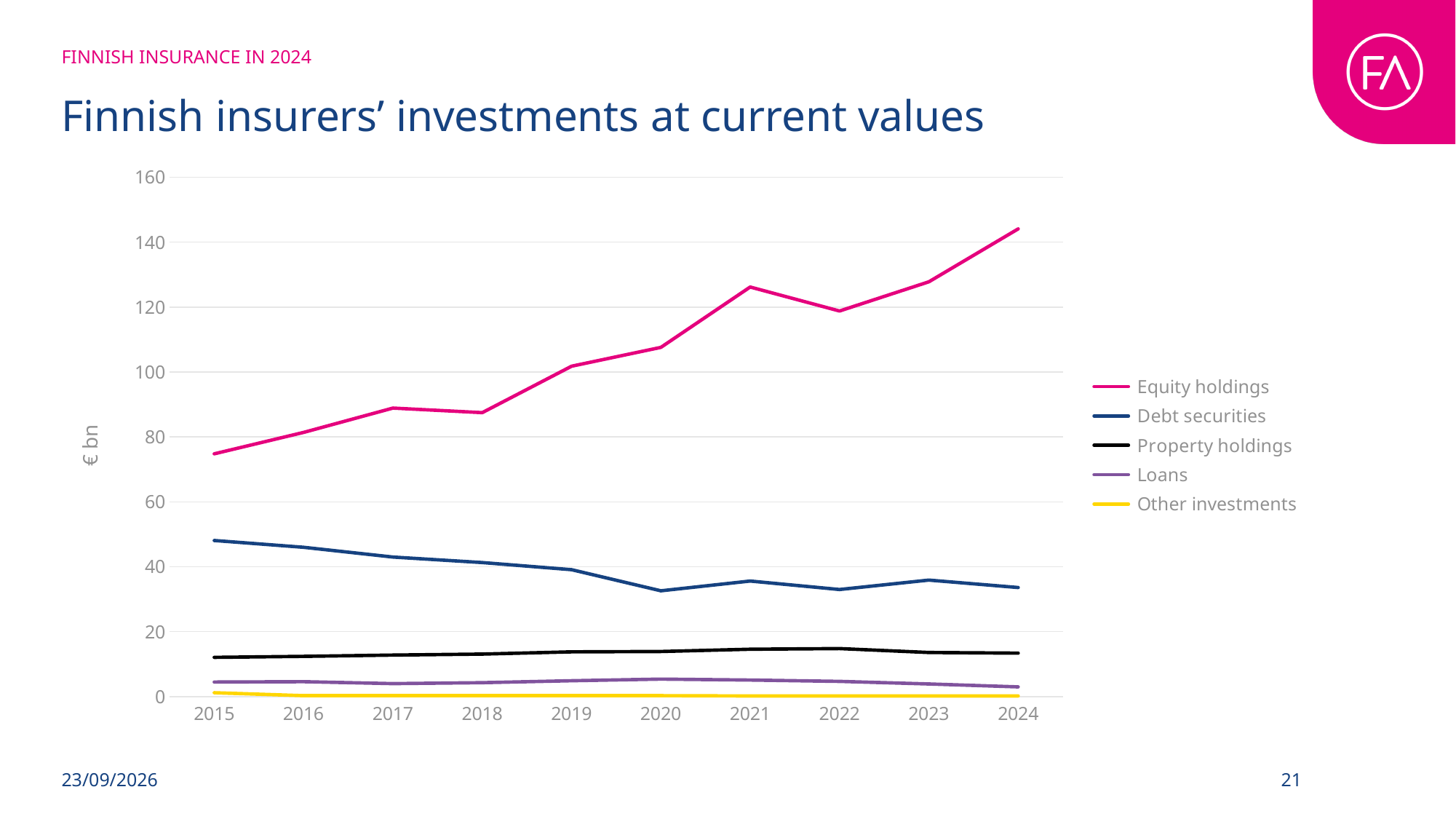
Do the values for Debt securities rise or fall from 2015 to 2024? fall Is the value for Equity holdings in 2015 greater or less than 80? less How many years are shown on the x axis? 10 What is the label on the y axis? € bn Which series has the lowest value in 2024? Other investments In 2020, which is larger: Debt securities or Property holdings? Debt securities Do the values for Equity holdings rise or fall from 2015 to 2024? rise Which series has the highest value in 2024? Equity holdings Is the value for Equity holdings in 2024 greater or less than 140? greater Is the value for Debt securities in 2020 greater or less than 40? less How many series does the legend list? 5 What kind of chart is shown on the slide? line chart